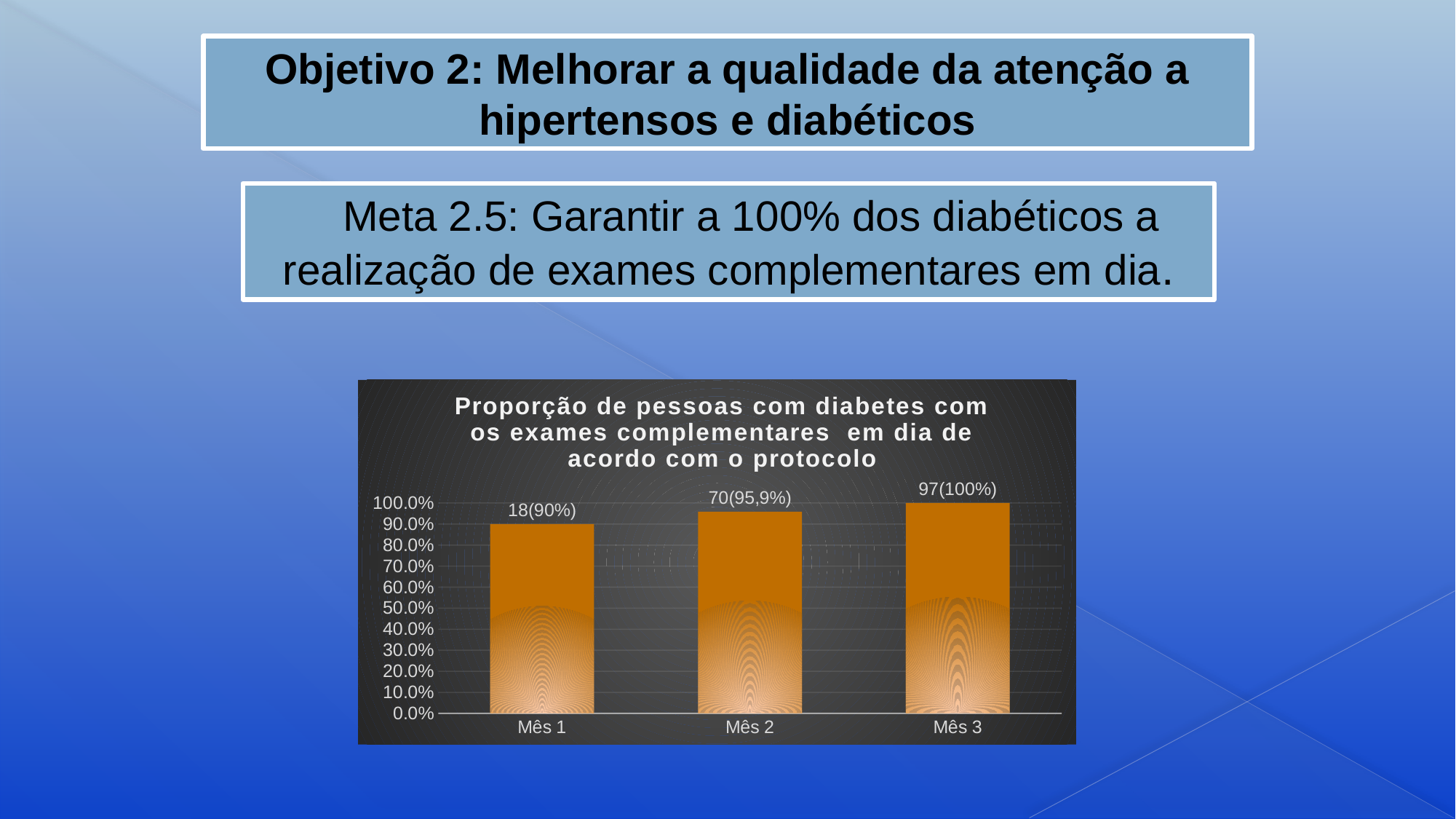
What data label is shown for Mês 2? 70(95,9%) What is the difference in percentage points between the proportion for Mês 3 and the proportion for Mês 1? 10 percentage points What data label is shown for Mês 3? 97(100%) How many months are shown on the x axis? 3 What is the title of the chart? Proporção de pessoas com diabetes com os exames complementares em dia de acordo com o protocolo Which is larger, the value for Mês 1 or the value for Mês 2? Mês 2 Is the value for Mês 1 greater or less than 80.0%? greater Which month has the lowest proportion? Mês 1 What data label is shown for Mês 1? 18(90%) Which month has the highest proportion? Mês 3 Do the values rise or fall from Mês 1 to Mês 3? rise What kind of chart is shown on the slide? bar chart